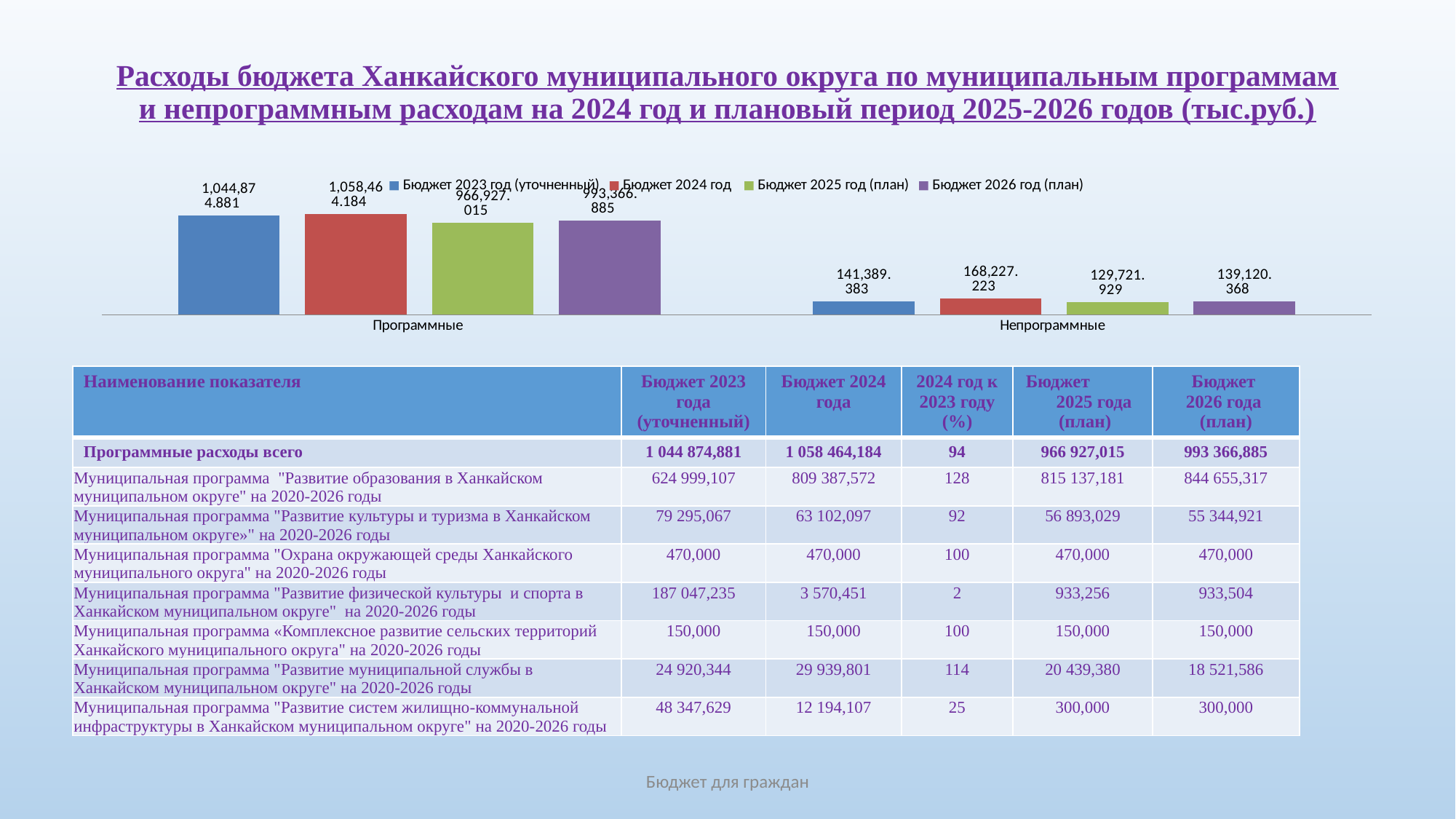
What is the value for Программные in the Бюджет 2025 год (план) series? 966,927.015 Which series has the lowest value for Программные? Бюджет 2025 год (план) How many series does the chart legend list? 4 What kind of chart is shown on the slide? Bar chart What is the difference between the Бюджет 2024 год and Бюджет 2023 год (уточненный) values for Непрограммные? 26,837.840 What is the value for Непрограммные in the Бюджет 2023 год (уточненный) series? 141,389.383 How many categories are shown on the x axis of the chart? 2 What is the difference between the Бюджет 2024 год and Бюджет 2023 год (уточненный) values for Программные? 13,589.303 What is the value for Программные in the Бюджет 2024 год series? 1,058,464.184 Which is larger for Непрограммные: the Бюджет 2025 год (план) value or the Бюджет 2026 год (план) value? Бюджет 2026 год (план) Which series has the highest value for Непрограммные? Бюджет 2024 год What is the value for Непрограммные in the Бюджет 2026 год (план) series? 139,120.368